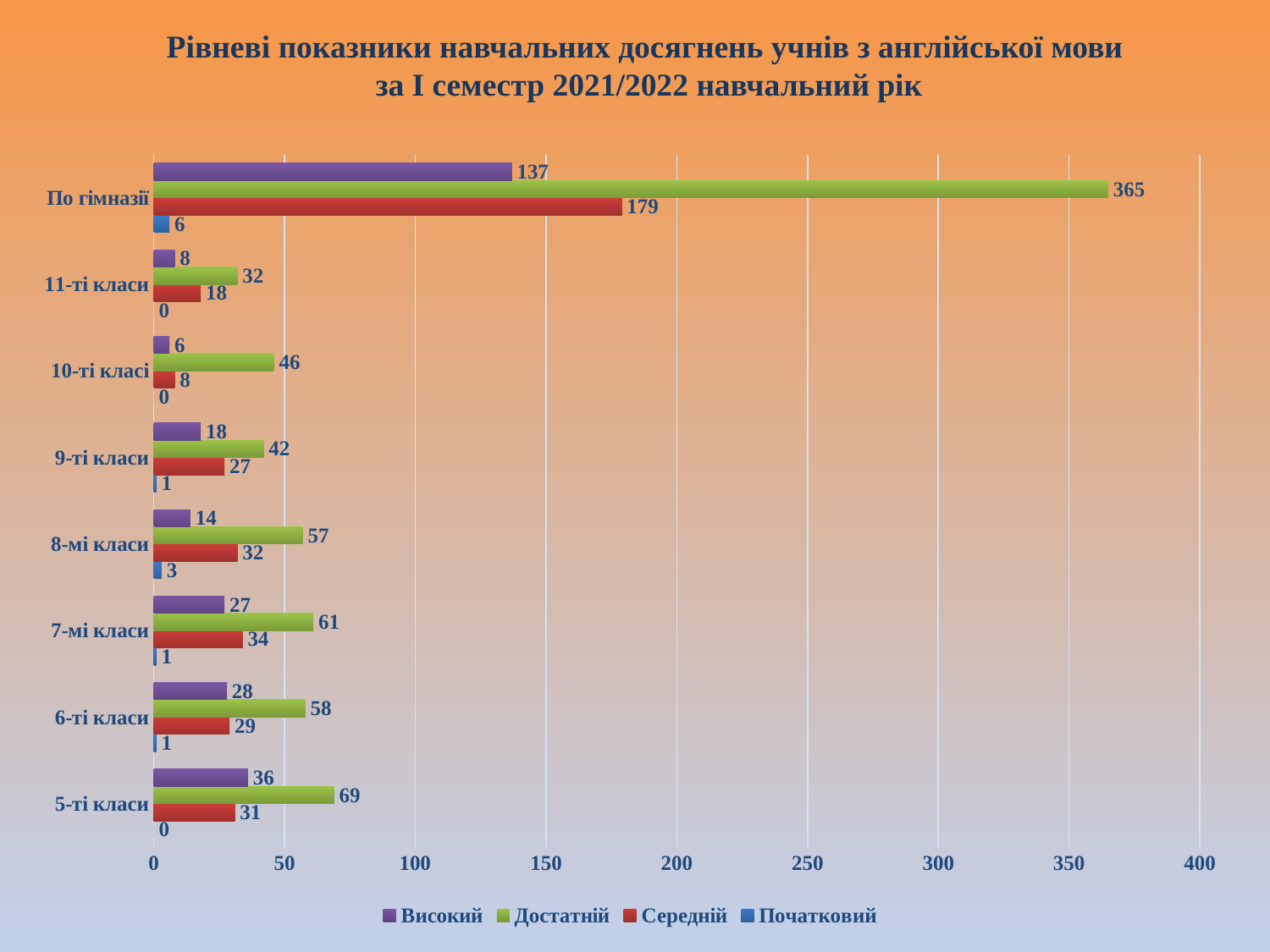
Which is larger for 6-ті класи: Високий or Середній? Середній What is the difference between the Достатній and Середній values for По гімназії? 186 Among the class groups (excluding По гімназії), which category has the lowest Високий value? 10-ті класі What is the value of Високий for 5-ті класи? 36 What is the value of Середній for 7-мі класи? 34 What is the value of Початковий for 8-мі класи? 3 Which colour represents the Середній series? Red Among the class groups (excluding По гімназії), which category has the highest Достатній value? 5-ті класи What is the value of Достатній for По гімназії? 365 How many series does the legend list? 4 How many categories are shown on the vertical axis? 8 What type of chart is shown on the slide? Bar chart